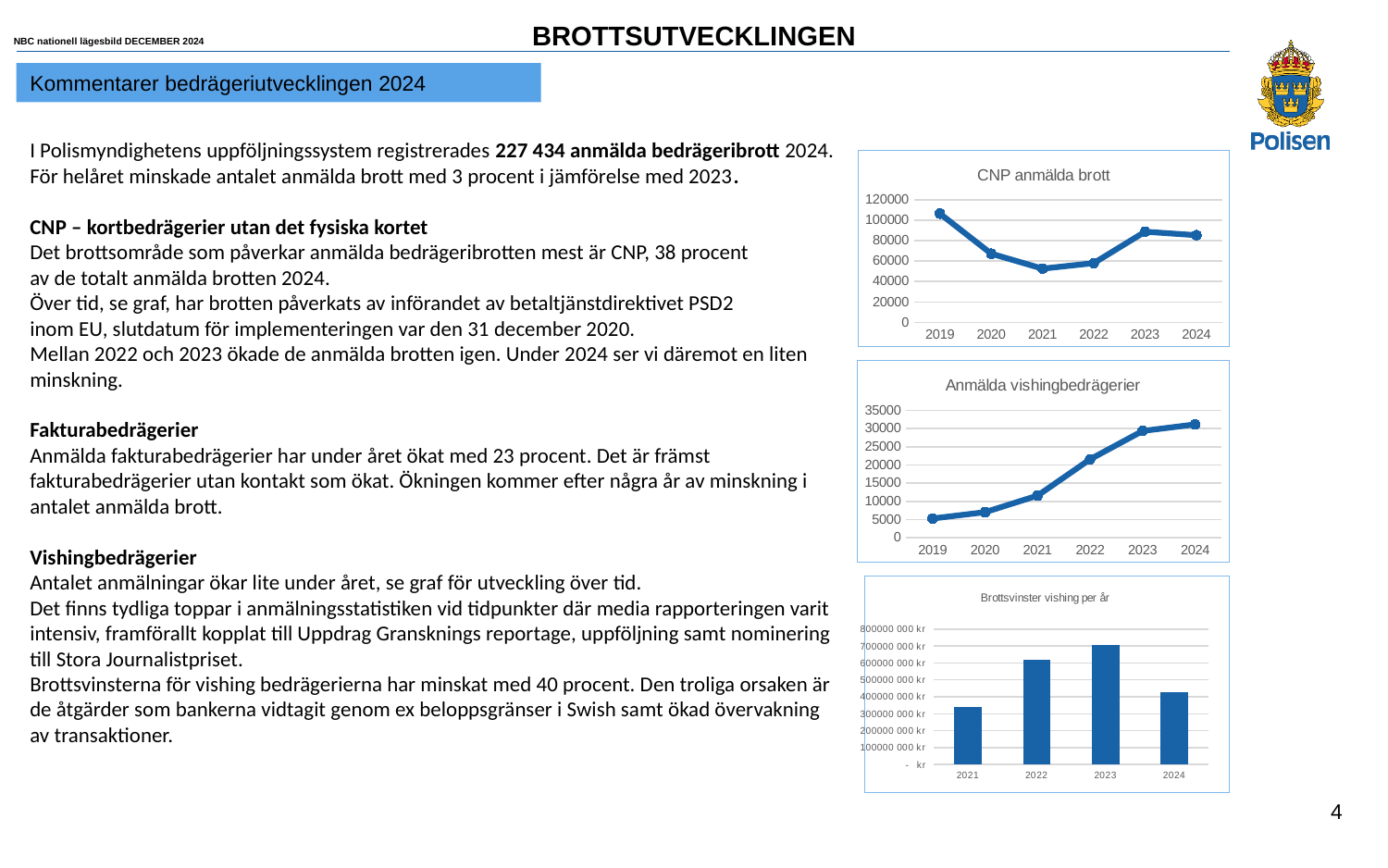
In the 'CNP anmälda brott' chart, which year has the lowest value? 2021 In the 'Anmälda vishingbedrägerier' chart, do the values rise or fall from 2019 to 2024? Rise In the 'Brottsvinster vishing per år' chart, which is larger, the value for 2022 or the value for 2024? 2022 In the 'CNP anmälda brott' chart, is the value for 2021 greater or less than 60000? less In the 'Anmälda vishingbedrägerier' chart, is the value for 2022 greater or less than 20000? greater How many years are plotted in the 'CNP anmälda brott' chart? 6 In the 'CNP anmälda brott' chart, is the value for 2019 greater or less than 100000? greater What kind of chart is 'Brottsvinster vishing per år'? Bar chart What kind of chart is 'Anmälda vishingbedrägerier'? Line chart In the 'Anmälda vishingbedrägerier' chart, which year has the lowest value? 2019 In the 'CNP anmälda brott' chart, which year has the highest value? 2019 In the 'Brottsvinster vishing per år' chart, which year has the highest bar? 2023